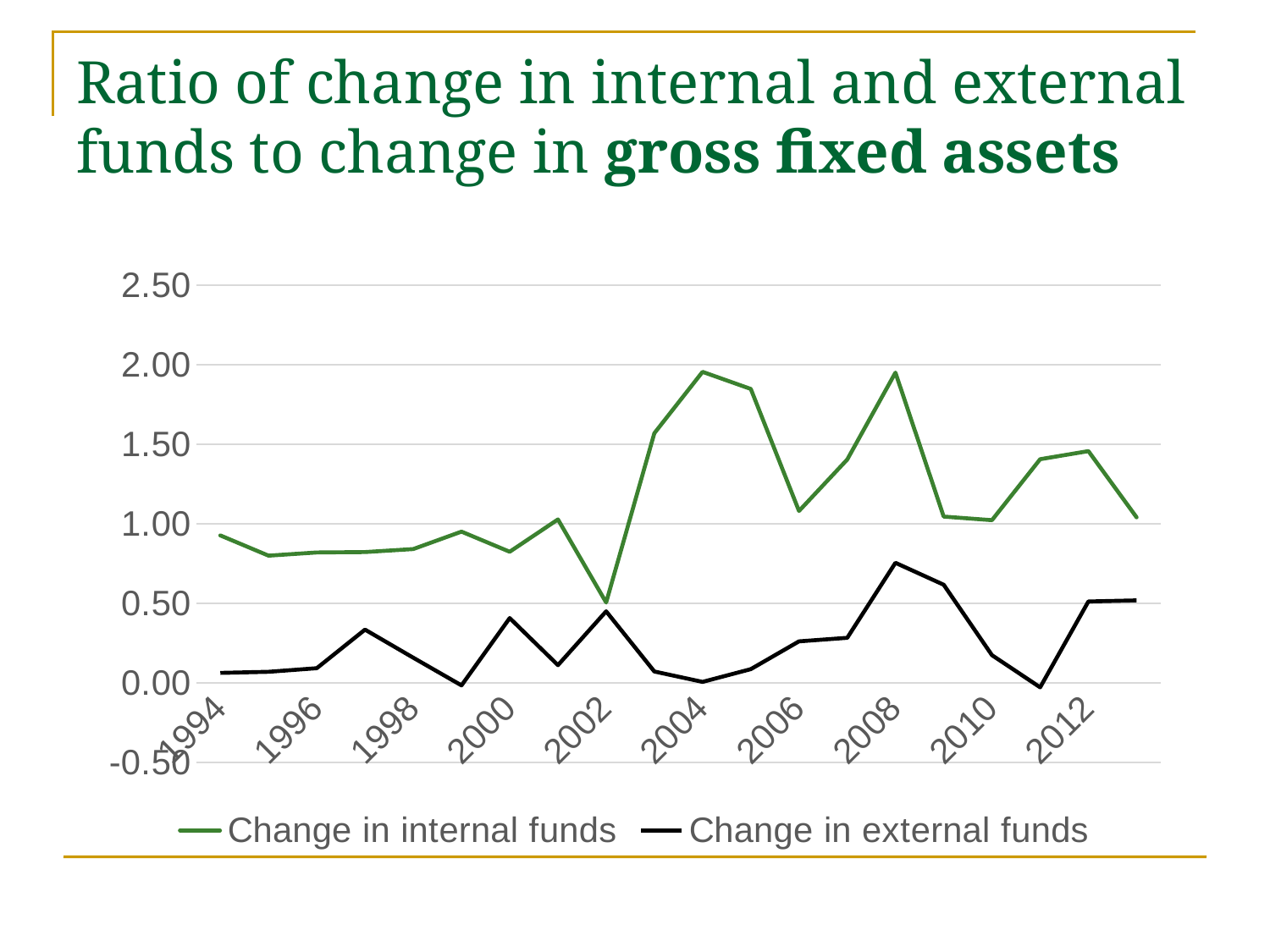
In which year does the Change in internal funds line reach its lowest value? 2002 In 2004, which series has the larger value, Change in internal funds or Change in external funds? Change in internal funds Is the value for Change in external funds in 1994 greater or less than 0.50? less Does the Change in internal funds line rise or fall between 2002 and 2004? rise How many series does the legend list? 2 Is the value for Change in external funds in 2008 greater or less than 0.50? greater In which year does the Change in external funds line reach its highest value? 2008 Is the value for Change in internal funds in 2004 greater or less than 1.50? greater Which series is plotted with the green line? Change in internal funds What kind of chart is shown on the slide? Line chart